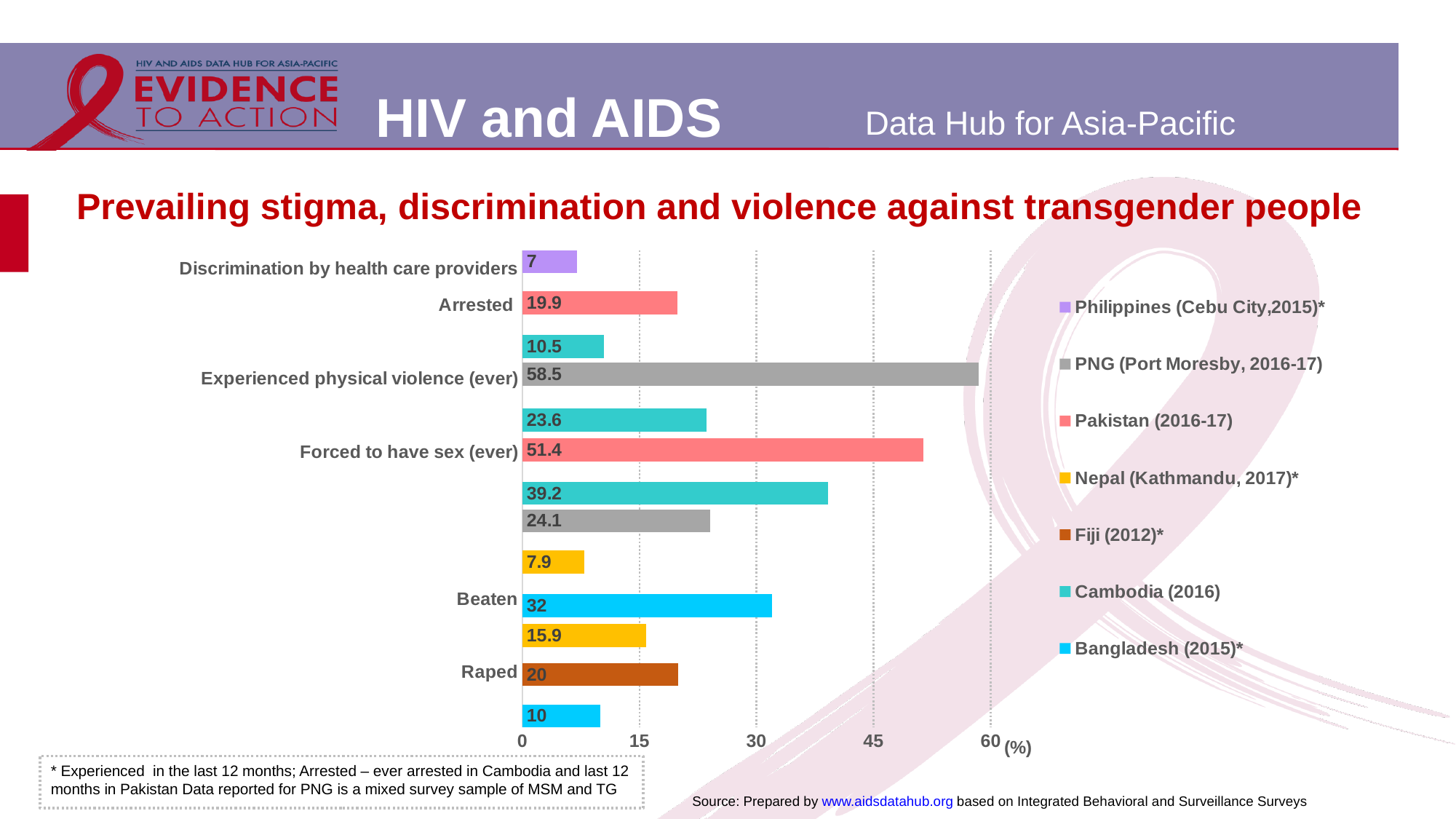
What is the value for Philippines (Cebu City, 2015) for Discrimination by health care providers? 7 What is the value for Pakistan (2016-17) for Arrested? 19.9 What is the value for PNG (Port Moresby, 2016-17) for Experienced physical violence (ever)? 58.5 What is the difference between PNG's value for Experienced physical violence (ever) and Pakistan's value for Forced to have sex (ever)? 7.1 What is the lowest value shown on the chart? 7 Which bar has the highest value on the chart? PNG (Port Moresby, 2016-17), Experienced physical violence (ever), 58.5 What is the value for Fiji (2012) for Raped? 20 What kind of chart is shown on the slide? Bar chart Is the value for PNG (Port Moresby, 2016-17) for Experienced physical violence (ever) greater or less than 45? greater How many series does the legend list? 7 What is the value for Pakistan (2016-17) for Forced to have sex (ever)? 51.4 What is the value for Bangladesh (2015) for Beaten? 32